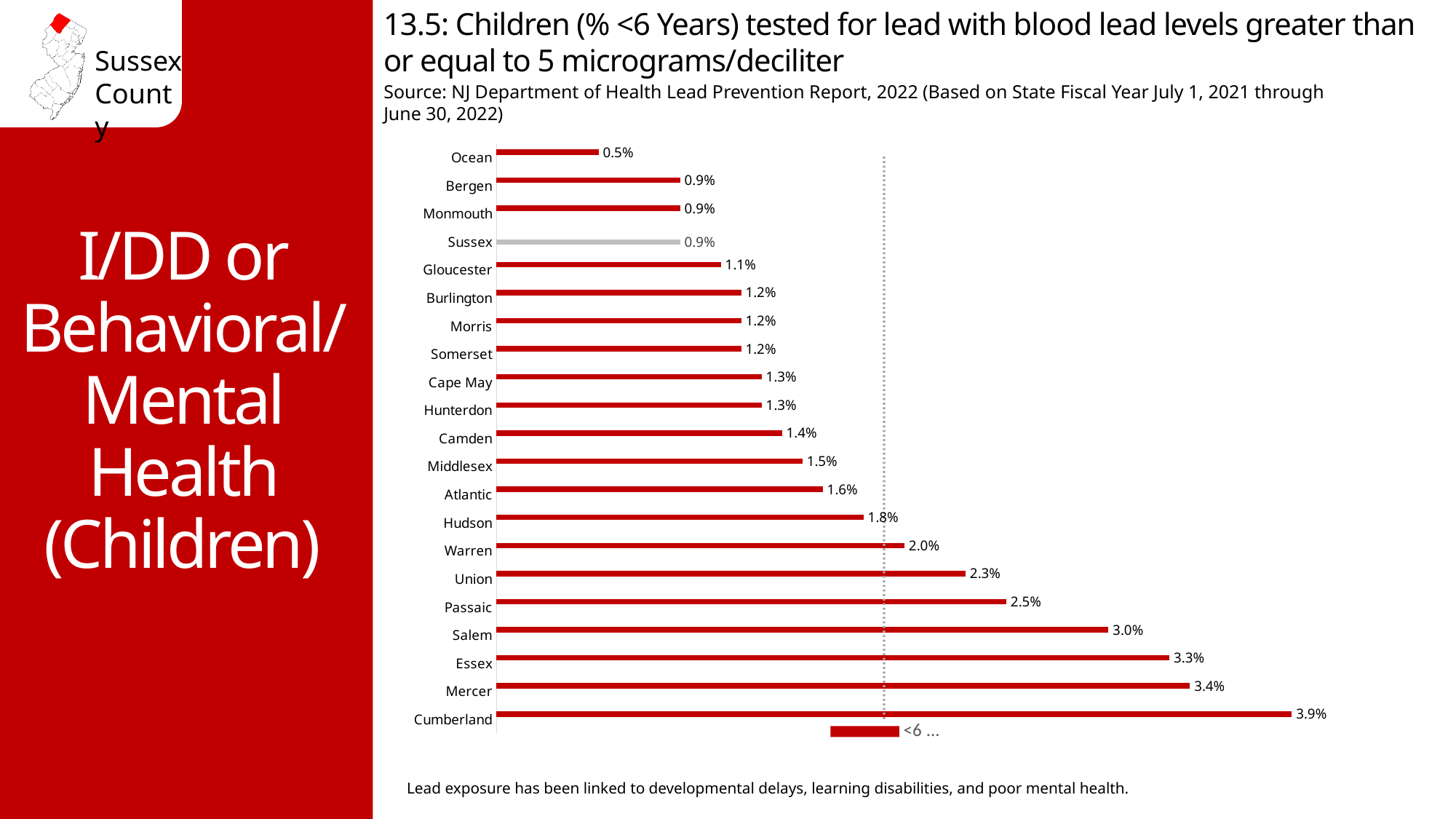
Which has a larger value, Passaic or Union? Passaic Which has a larger value, Hudson or Atlantic? Hudson What kind of chart is shown on the slide? Bar chart Which county's bar is shown in grey rather than red? Sussex What is the value for Sussex? 0.9% How many counties are shown in the chart? 21 What is the value for Cumberland? 3.9% What is the value for Warren? 2.0% Which county has the lowest value? Ocean Which county has the highest value? Cumberland What is the difference between the values for Mercer and Essex? 0.1% What is the difference between the values for Cumberland and Sussex? 3.0%